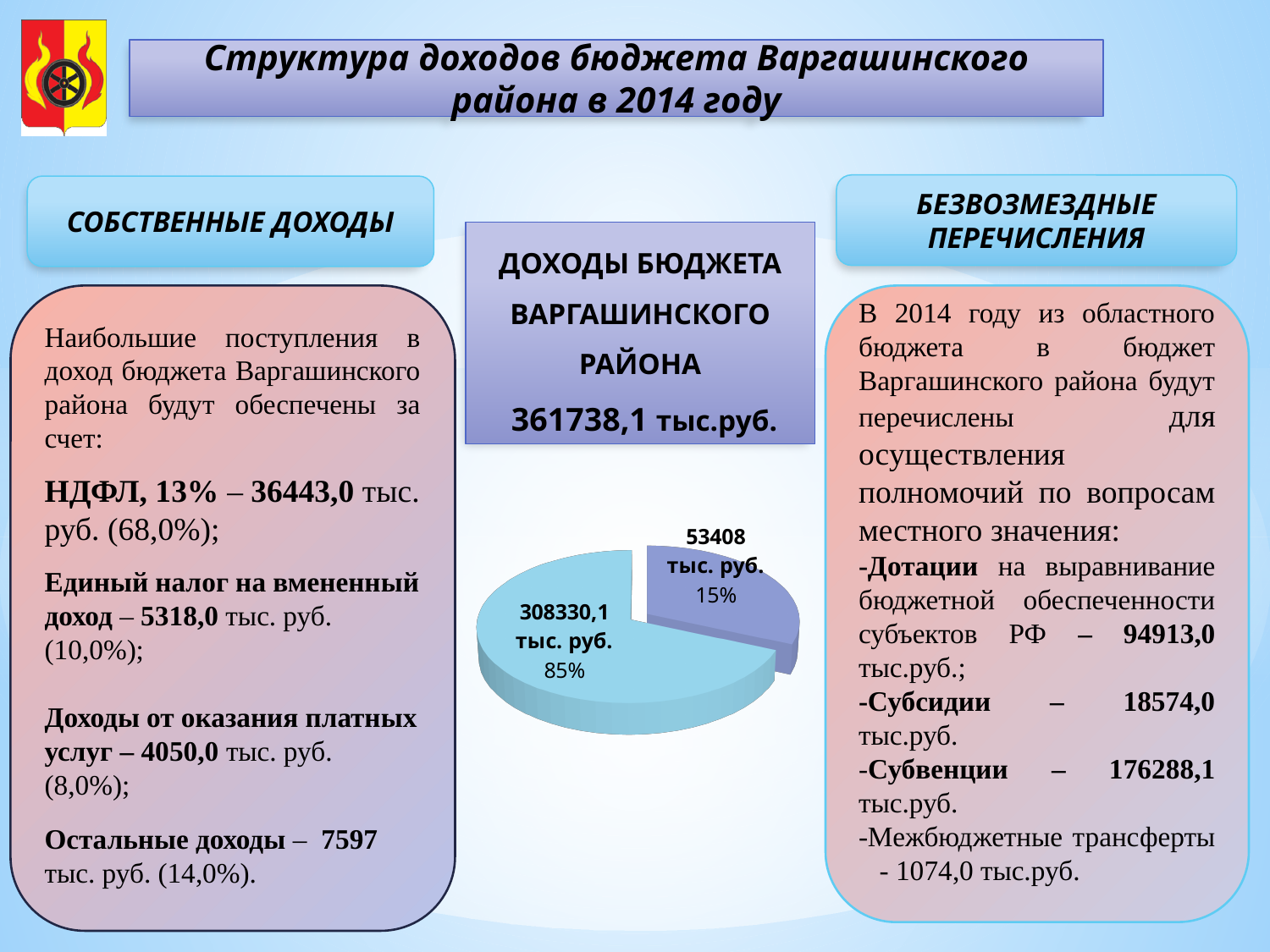
What share of the pie does the slice labelled 53408 тыс. руб. represent? 15% How many slices does the pie chart have? 2 What value is printed on the larger slice of the pie chart? 308330,1 тыс. руб. What share of the pie does the slice labelled 308330,1 тыс. руб. represent? 85% What kind of chart is shown on the slide? pie chart What is the total of the two slice values shown in the pie chart? 361738,1 тыс. руб. What colour is the 15% slice of the pie chart? purple What is the difference between the two slice values in the pie chart (308330,1 and 53408 тыс. руб.)? 254922,1 тыс. руб. What colour is the 85% slice of the pie chart? light blue What value is printed on the smaller slice of the pie chart? 53408 тыс. руб. Which slice has the largest share of the pie chart? the 85% slice (308330,1 тыс. руб.) Which slice of the pie chart is larger: the one labelled 308330,1 тыс. руб. or the one labelled 53408 тыс. руб.? 308330,1 тыс. руб.